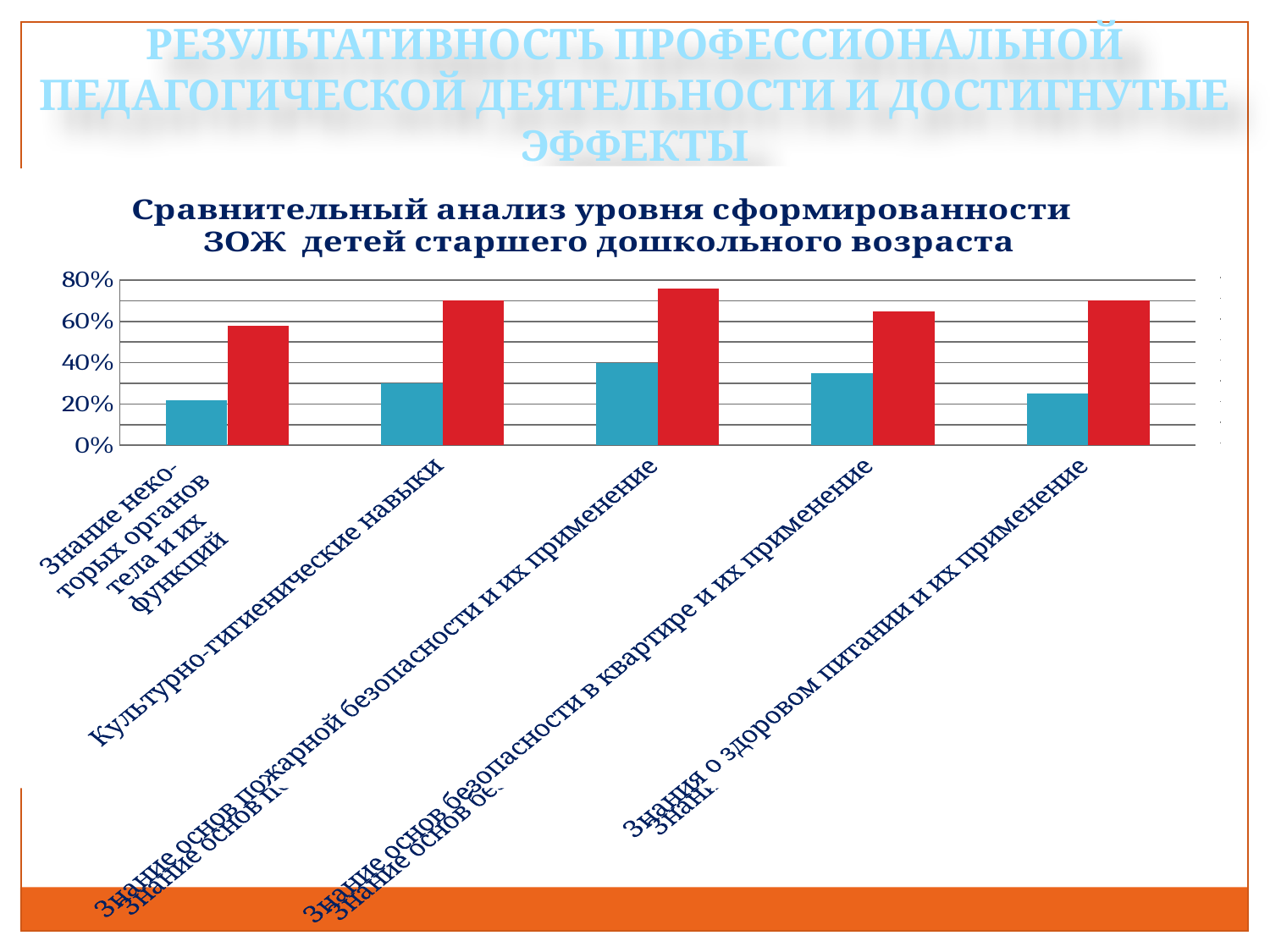
What is the title of the chart? Сравнительный анализ уровня сформированности ЗОЖ детей старшего дошкольного возраста Is the red bar for 'Знания о здоровом питании и их применение' greater or less than 40%? greater Which category has the lowest blue bar? Знание некоторых органов тела и их функций How many categories are shown on the x axis of the chart? 5 Is the red bar for 'Знание основ пожарной безопасности и их применение' greater or less than 60%? greater Which category has the highest red bar? Знание основ пожарной безопасности и их применение What is the highest value shown on the vertical axis of the chart? 80% What kind of chart is shown on the slide? bar chart For 'Культурно-гигиенические навыки', which bar is larger, the blue one or the red one? the red one Is the blue bar for 'Знание некоторых органов тела и их функций' greater or less than 40%? less Which category has the lowest red bar? Знание некоторых органов тела и их функций Which category has the highest blue bar? Знание основ пожарной безопасности и их применение